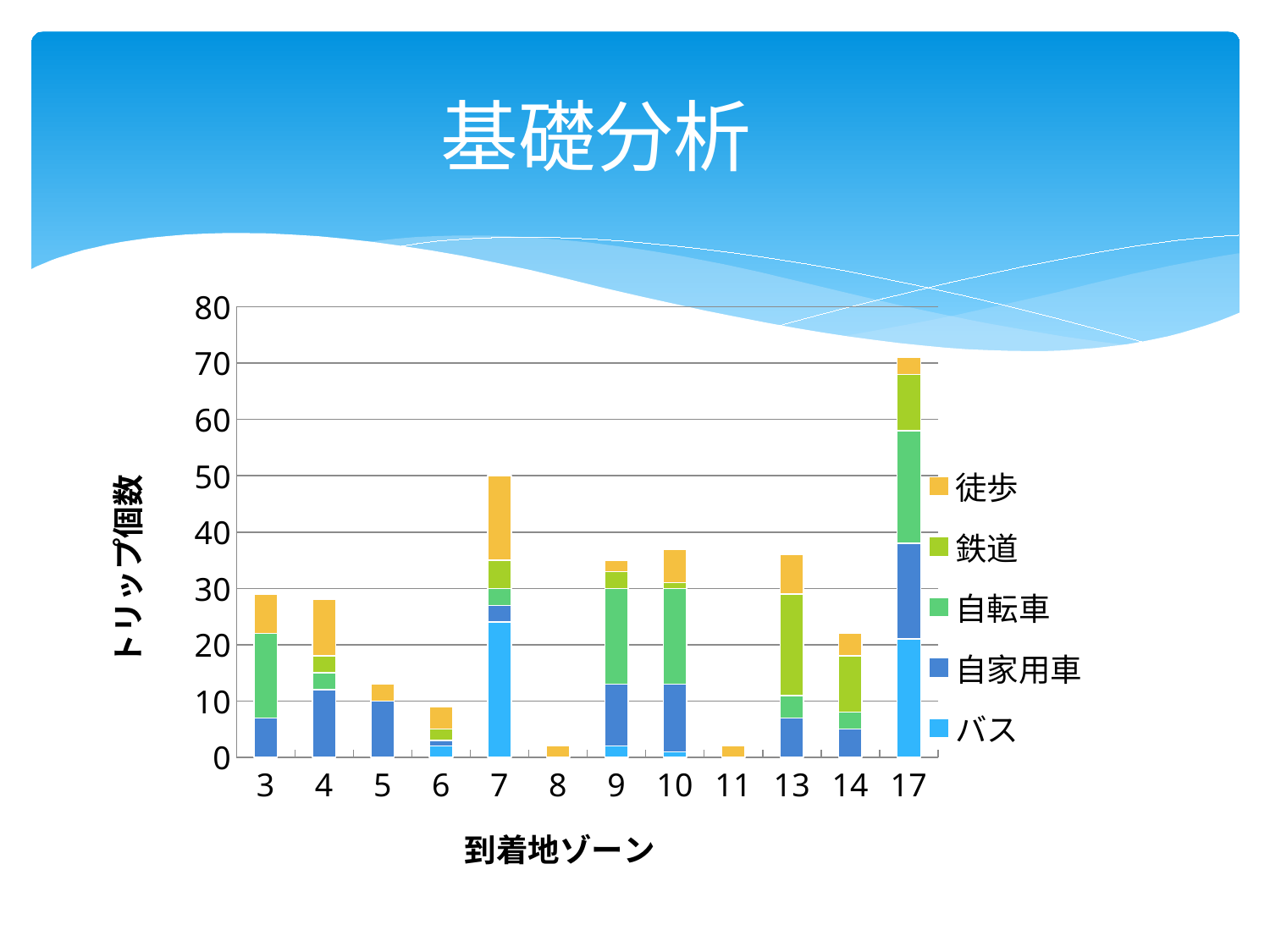
What kind of chart is shown on the slide? stacked bar chart Is the total number of trips for zone 13 greater or less than 30? greater Which destination zone has the highest total number of trips? 17 Is the total number of trips for zone 17 greater or less than 60? greater How many series does the legend list? 5 Which has a larger total number of trips, zone 4 or zone 5? 4 Which has a larger total number of trips, zone 17 or zone 7? 17 Is the total number of trips for zone 14 greater or less than 30? less What is the title of the x axis? 到着地ゾーン How many destination zones (到着地ゾーン) are shown on the x axis? 12